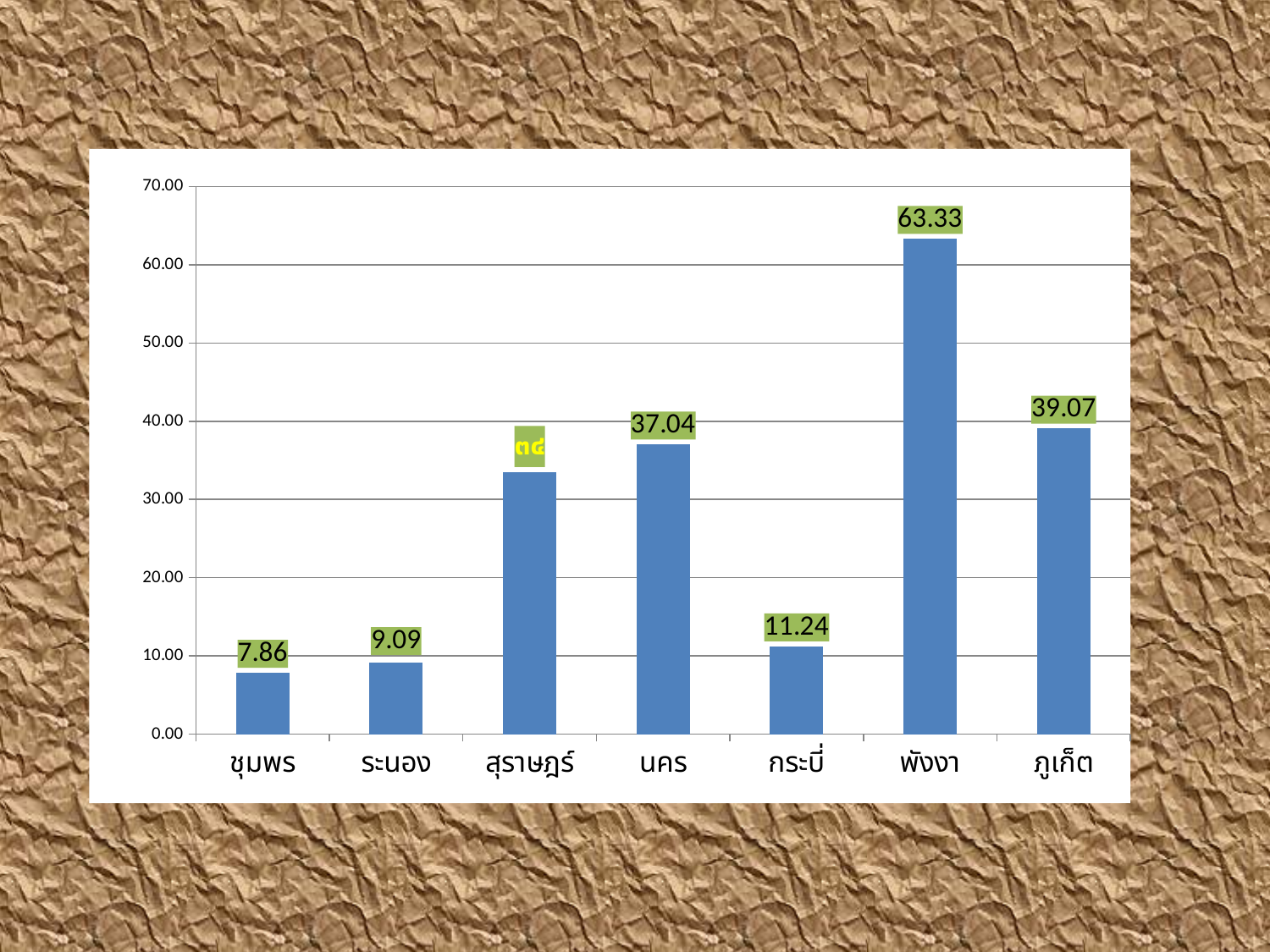
What is the value for ระนอง? 9.09 What is the value for ชุมพร? 7.86 What is the value for นคร? 37.04 Which category has the lowest value? ชุมพร What is the value for กระบี่? 11.24 Which category has the highest value? พังงา What type of chart is shown on the slide? bar chart What is the value for พังงา? 63.33 Is the value for สุราษฎร์ greater or less than 30.00? greater How many categories are shown on the x axis of the chart? 7 What is the value for ภูเก็ต? 39.07 What is the difference between the values for พังงา and ภูเก็ต? 24.26